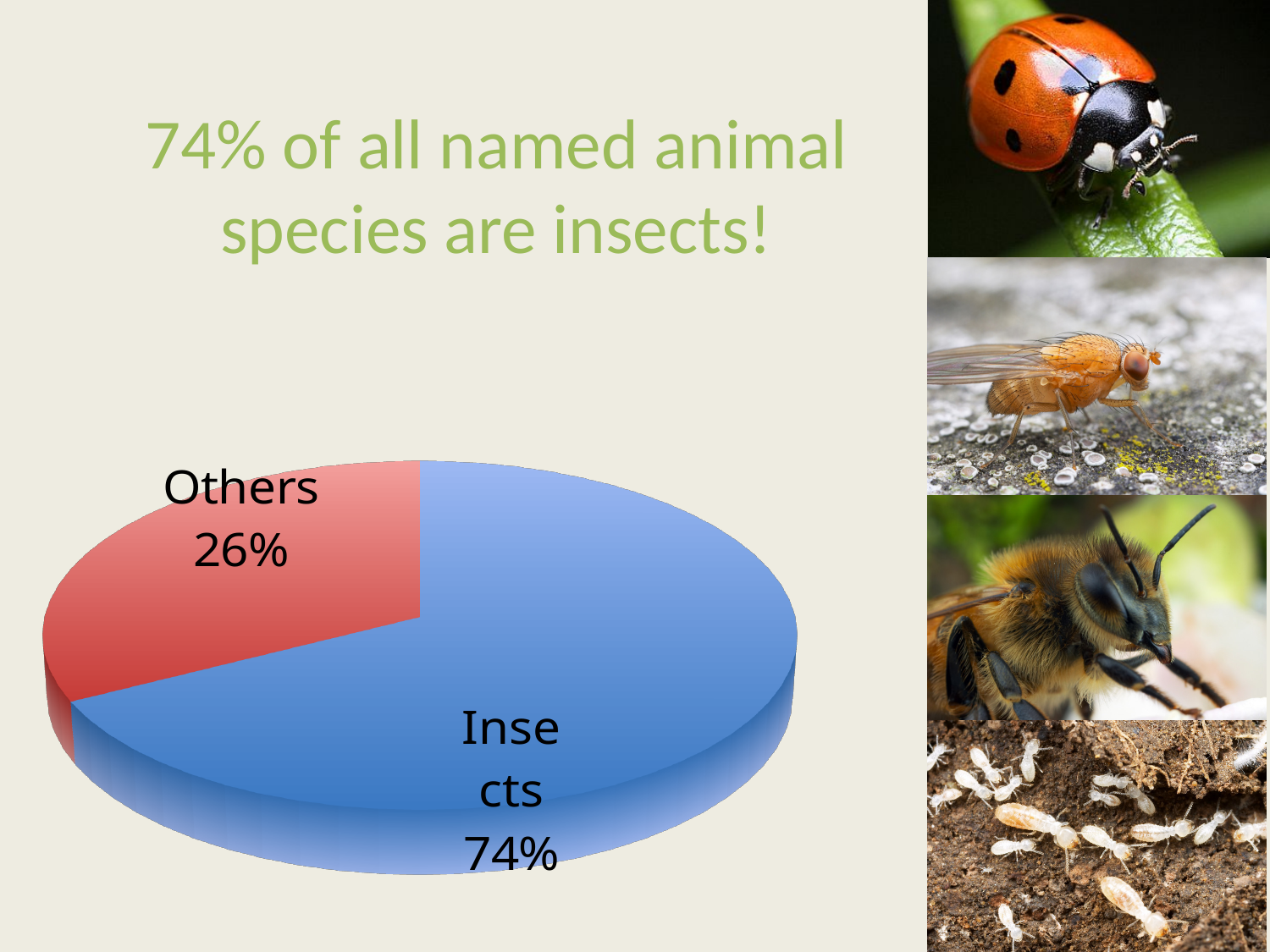
How many slices does the pie chart have? 2 Which slice of the pie is the largest? Insects What share of the pie does the Insects slice represent? 74% What colour is the Insects slice of the pie? blue What kind of chart is shown on the slide? pie chart What is the difference in percentage points between the Insects slice and the Others slice? 48 Which slice of the pie is the smallest? Others Which is larger, the Insects slice or the Others slice? Insects What share of the pie does the Others slice represent? 26% What colour is the Others slice of the pie? red Is the value for Insects greater or less than 50%? greater